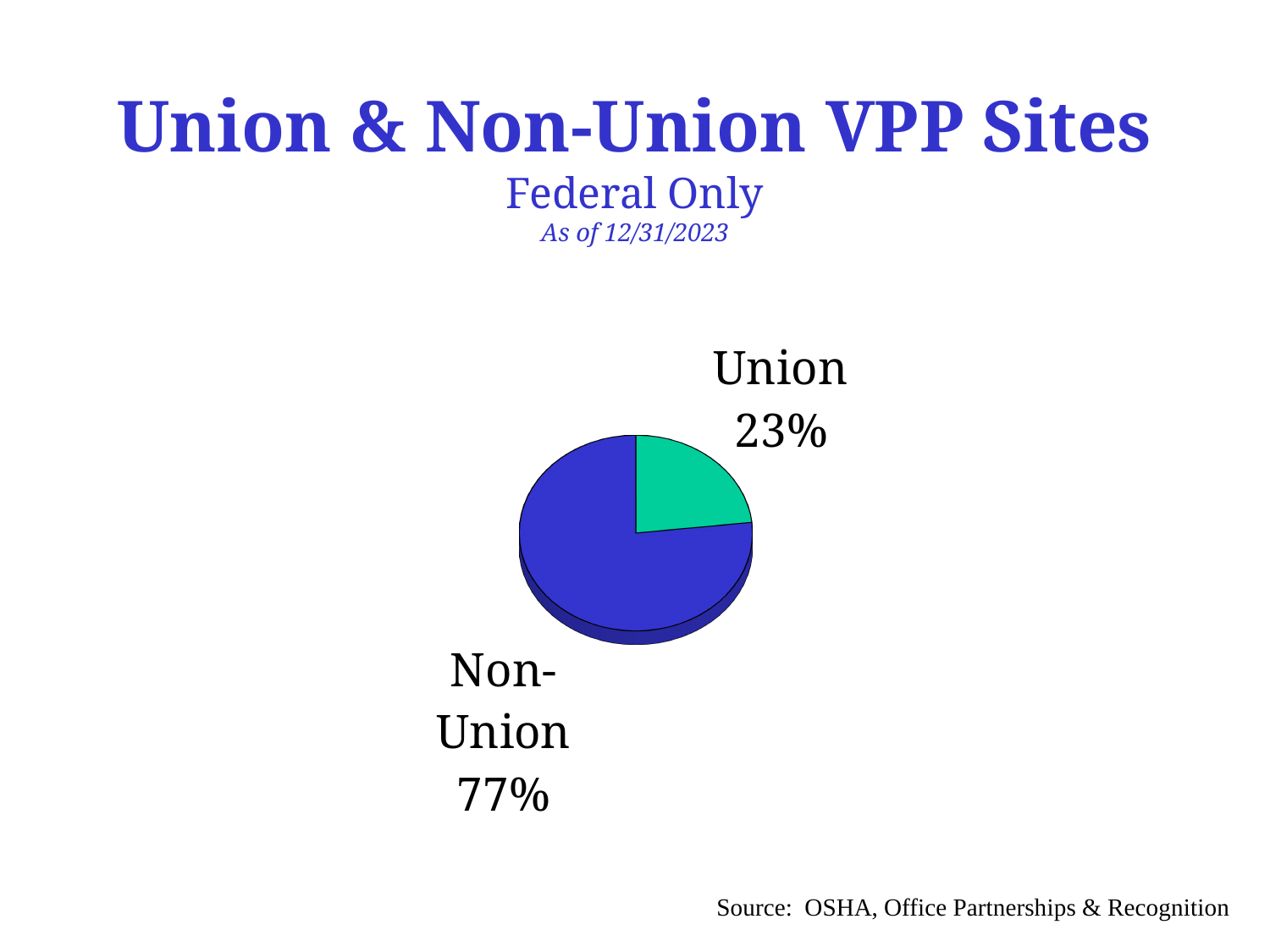
Which category has the larger share of the pie? Non-Union Is the Union share larger or smaller than the Non-Union share? smaller What percentage of federal VPP sites are Non-Union? 77% What share of the pie does the Union slice represent? 23% How many slices does the pie chart have? 2 Which category has the smaller share of the pie? Union What kind of chart is shown on the slide? pie chart What is the difference in percentage points between the Non-Union and Union shares? 54 As of what date is the data on the slide reported? 12/31/2023 What percentage of federal VPP sites are Union? 23% What colour is the Non-Union slice of the pie? blue What is the title of the chart on the slide? Union & Non-Union VPP Sites